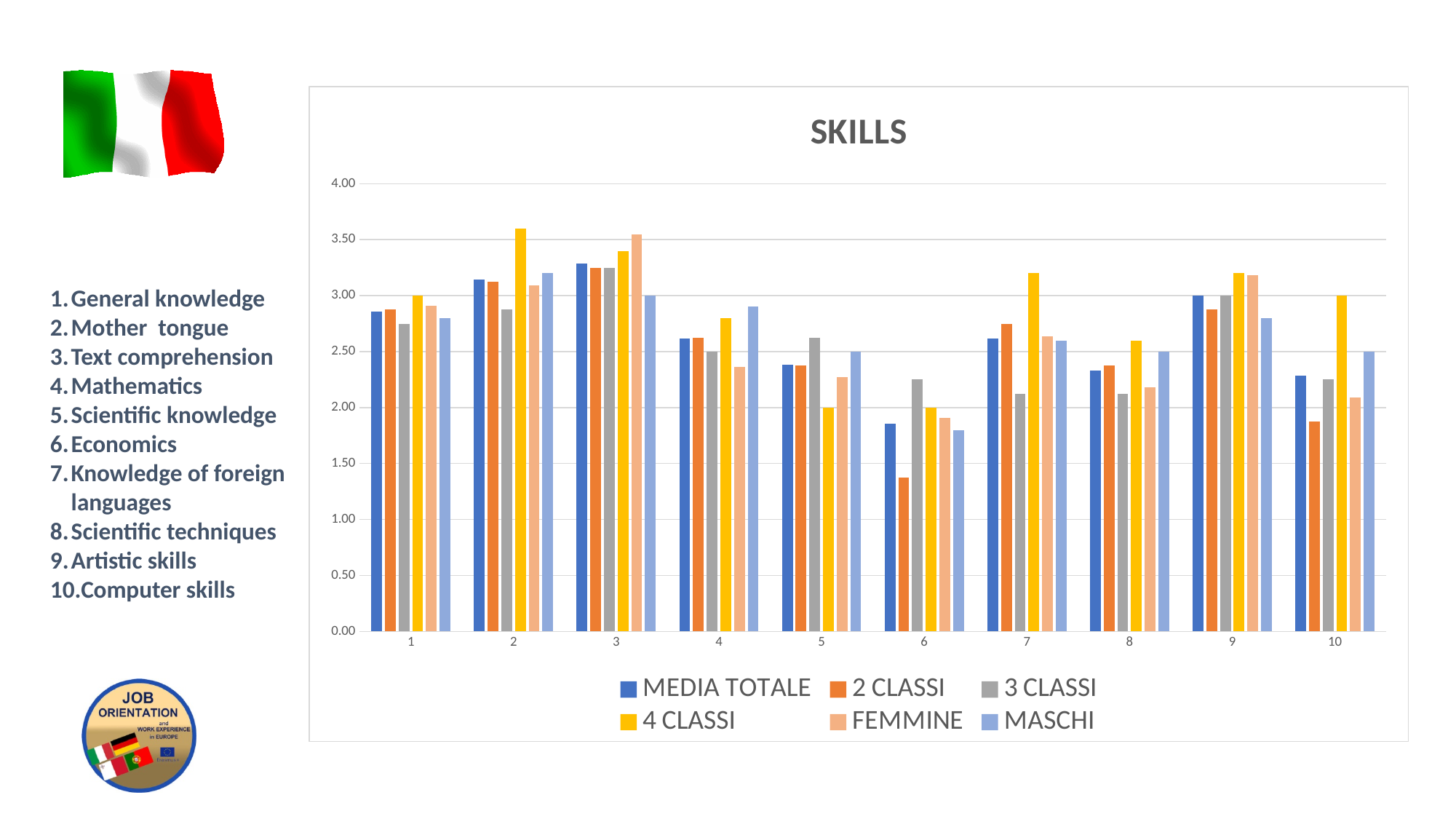
For category 10, which is larger: the 4 CLASSI value or the 2 CLASSI value? 4 CLASSI For which category is the 4 CLASSI bar the highest? 2 Is the MEDIA TOTALE value for category 6 greater or less than 2.00? less What is the title of the chart? SKILLS Is the FEMMINE value for category 3 greater or less than 3.00? greater What kind of chart is shown on the slide? bar chart How many series does the chart legend list? 6 Is the 4 CLASSI value for category 7 greater or less than 3.00? greater Which series is drawn in yellow in the chart? 4 CLASSI For which category is the 2 CLASSI bar the lowest? 6 How many categories are shown along the x axis of the chart? 10 For category 4, which is larger: the MASCHI value or the FEMMINE value? MASCHI